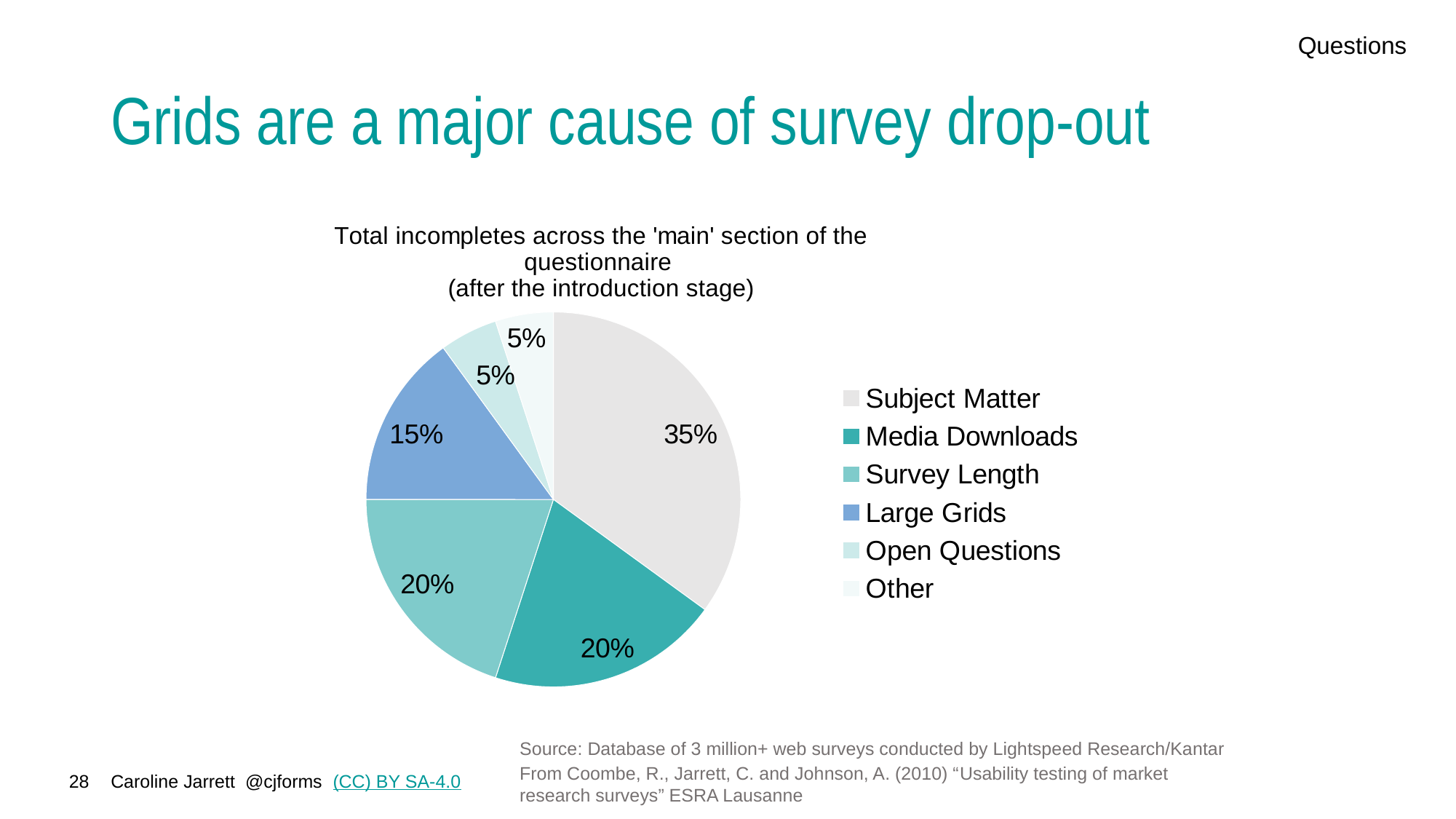
What share of total incompletes is attributed to Media Downloads? 20% What kind of chart is shown on the slide? pie chart Which is larger, the share for Survey Length or the share for Large Grids? Survey Length What is the combined share of Open Questions and Other? 10% Which legend entry is listed last? Other What is the title of the pie chart? Total incompletes across the 'main' section of the questionnaire (after the introduction stage) What share of total incompletes is attributed to Large Grids? 15% What share of total incompletes is attributed to Open Questions? 5% What is the difference in percentage points between Subject Matter and Large Grids? 20 How many categories does the pie chart show? 6 Which category accounts for the largest share of incompletes? Subject Matter What share of total incompletes is attributed to Subject Matter? 35%